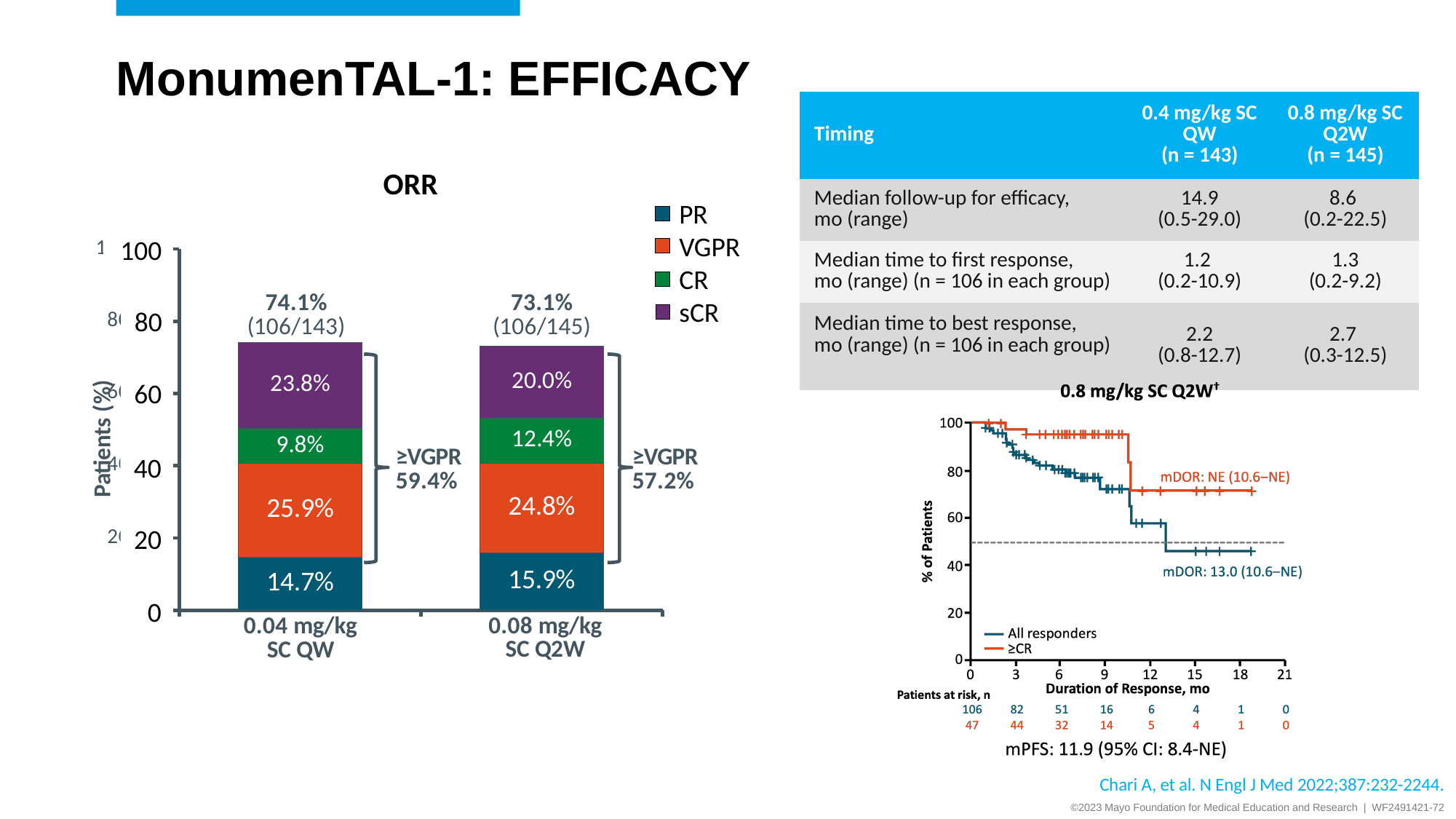
In the ORR bar chart, what is the CR value for 0.04 mg/kg SC QW? 9.8% In the ORR bar chart, what is the VGPR value for 0.08 mg/kg SC Q2W? 24.8% In the ORR bar chart, what is the sCR value for 0.04 mg/kg SC QW? 23.8% In the ORR bar chart, which dosing group has the higher CR value? 0.08 mg/kg SC Q2W How many series does the legend of the ORR bar chart list? 4 In the Kaplan-Meier chart for 0.8 mg/kg SC Q2W, how many ≥CR patients were at risk at 6 months? 32 In the ORR bar chart, which segment is the largest within the 0.04 mg/kg SC QW bar? VGPR In the ORR bar chart, what is the ≥VGPR rate shown for 0.04 mg/kg SC QW? 59.4% In the Kaplan-Meier chart for 0.8 mg/kg SC Q2W, what is the mDOR for all responders? 13.0 (10.6–NE) In the ORR bar chart, what is the difference between the PR values for 0.08 mg/kg SC Q2W and 0.04 mg/kg SC QW? 1.2% In the ORR bar chart, what is the total ORR shown above the 0.08 mg/kg SC Q2W bar? 73.1% What kind of chart is the ORR chart? Stacked bar chart